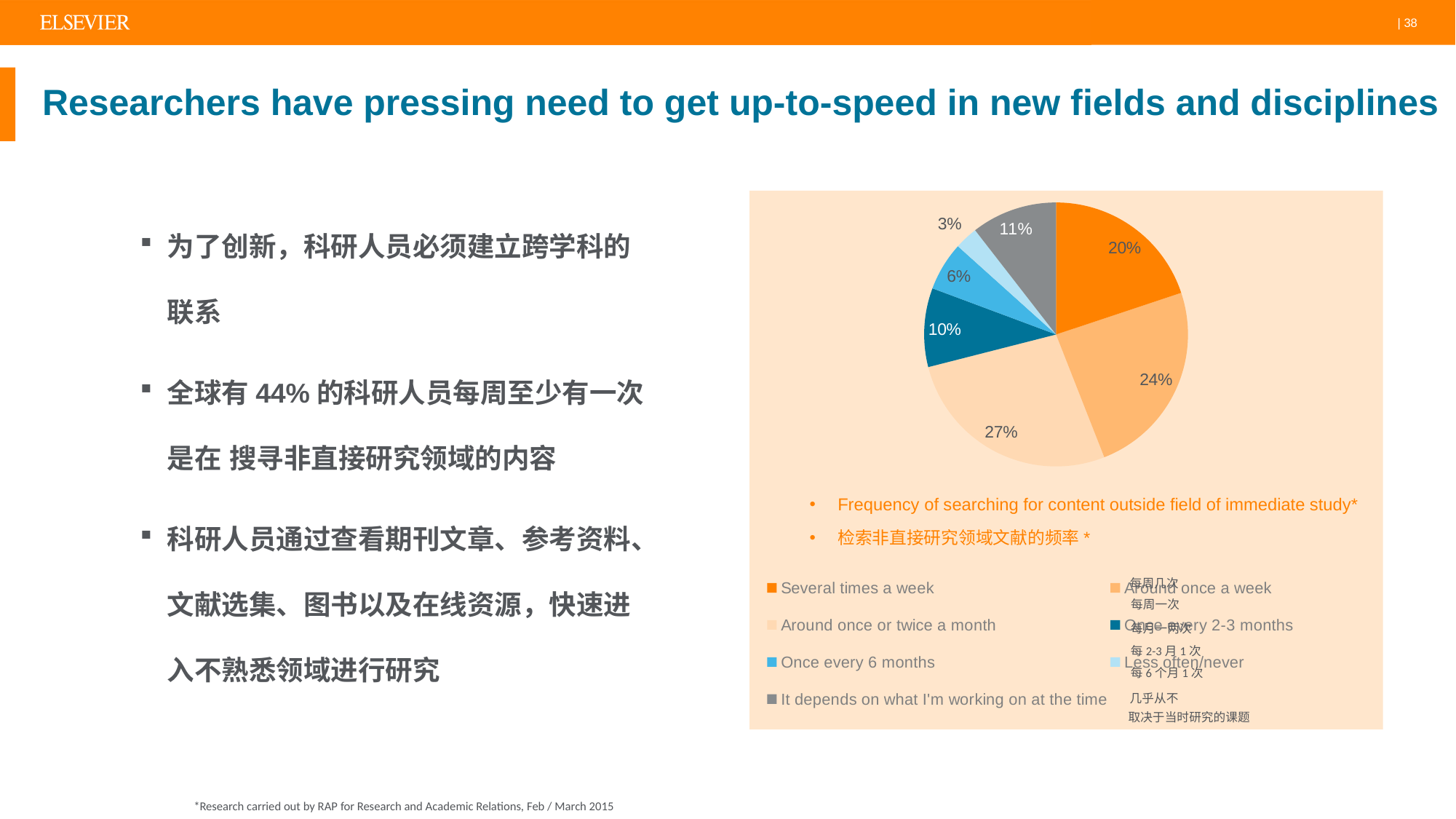
Which slice is larger: "Once every 6 months" or "Once every 2-3 months"? Once every 2-3 months What kind of chart is shown on the slide? pie chart Which category has the smallest slice of the pie? Less often/never What is the difference in percentage points between the "Around once or twice a month" slice and the "Several times a week" slice? 7 What share of the pie is labelled "It depends on what I'm working on at the time"? 11% How many slices does the pie chart have? 7 What share of the pie is labelled "Around once or twice a month"? 27% What share of the pie is labelled "Around once a week"? 24% What is the English caption given below the pie chart? Frequency of searching for content outside field of immediate study* What share of the pie is labelled "Several times a week"? 20% What share of the pie is labelled "Once every 2-3 months"? 10% Which category has the largest slice of the pie? Around once or twice a month